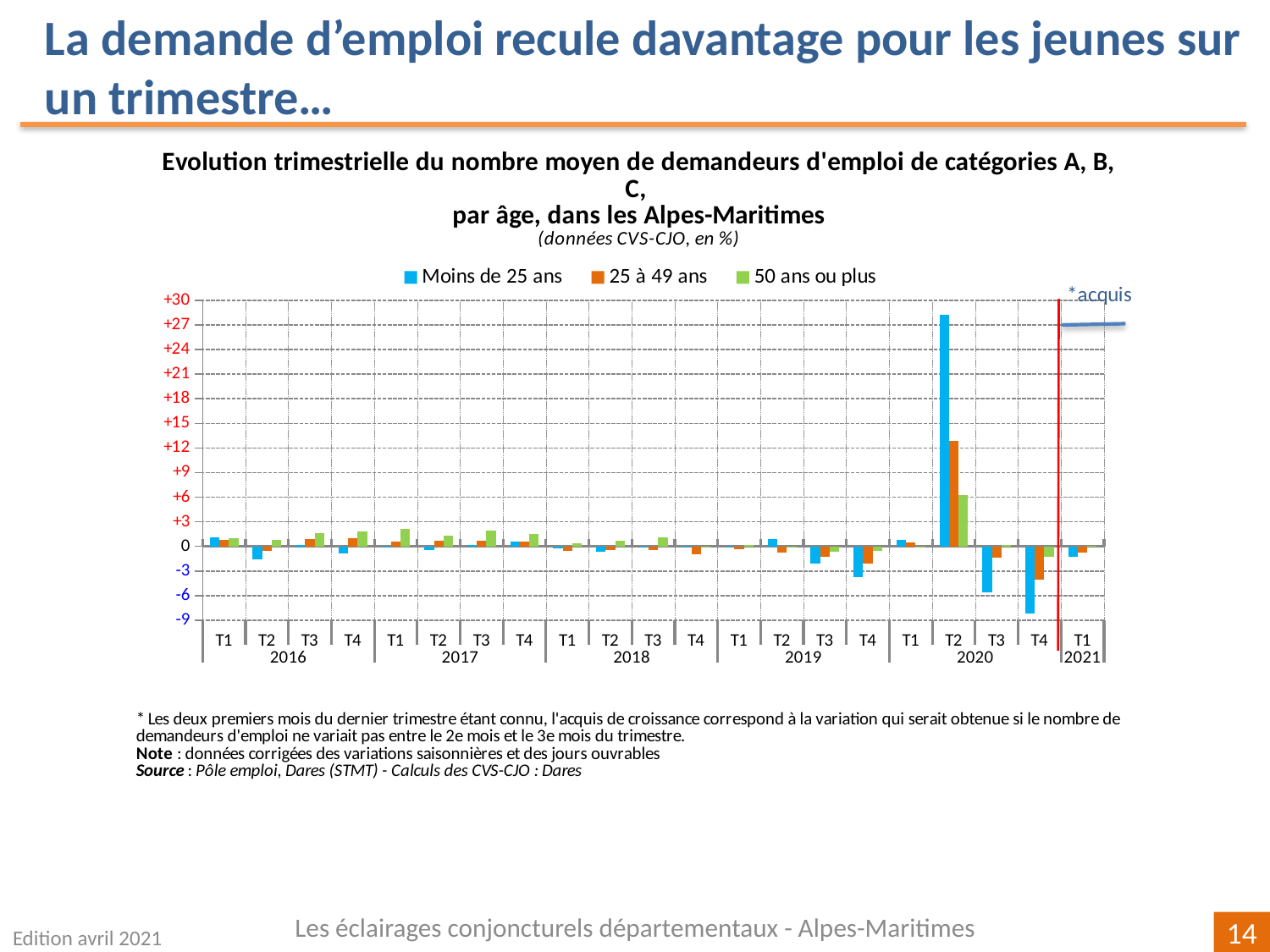
In which quarter does the 'Moins de 25 ans' series reach its lowest value? T4 2020 Which colour represents the '25 à 49 ans' series in the legend? orange Is the value for 'Moins de 25 ans' in T4 2020 greater or less than -6? less In which quarter does the 'Moins de 25 ans' series reach its highest value? T2 2020 How many quarters are plotted along the x axis? 21 Is the value for '25 à 49 ans' in T2 2020 greater or less than +9? greater In T2 2020, which series has the larger value: 'Moins de 25 ans' or '50 ans ou plus'? Moins de 25 ans Is the value for '25 à 49 ans' in T2 2020 greater or less than +15? less How many series does the legend list? 3 What kind of chart is shown on the slide? bar chart